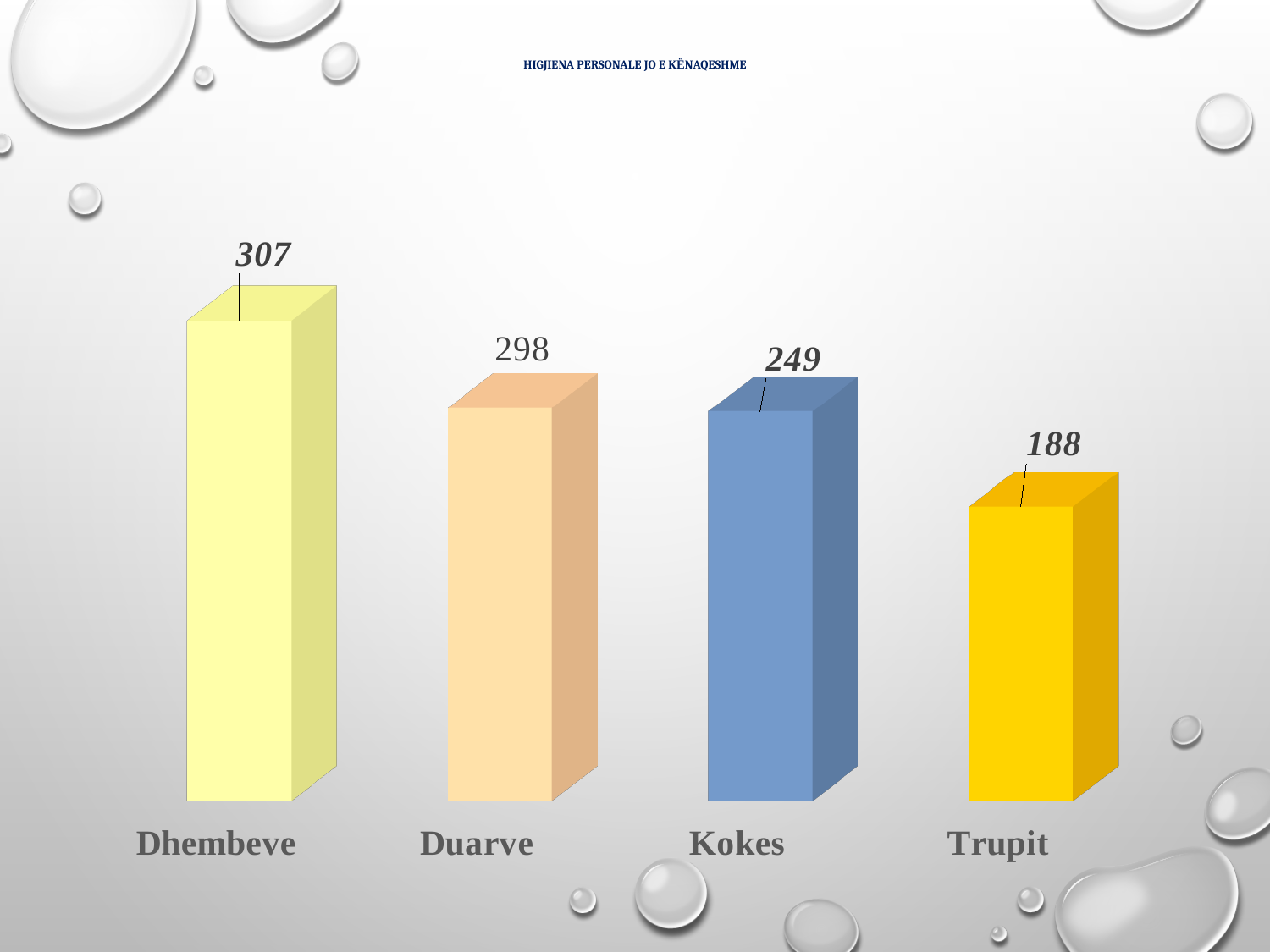
What is the difference between the values for Kokes and Trupit? 61 What is the difference between the values for Dhembeve and Trupit? 119 Which is larger, the value for Duarve or the value for Kokes? Duarve Do the values rise or fall from left to right across the categories? Fall Which category has the highest value? Dhembeve What is the value for Duarve? 298 What is the value for Trupit? 188 What is the value for Dhembeve? 307 What kind of chart is shown on the slide? Bar chart Which category has the lowest value? Trupit How many categories are shown in the chart? 4 What is the value for Kokes? 249